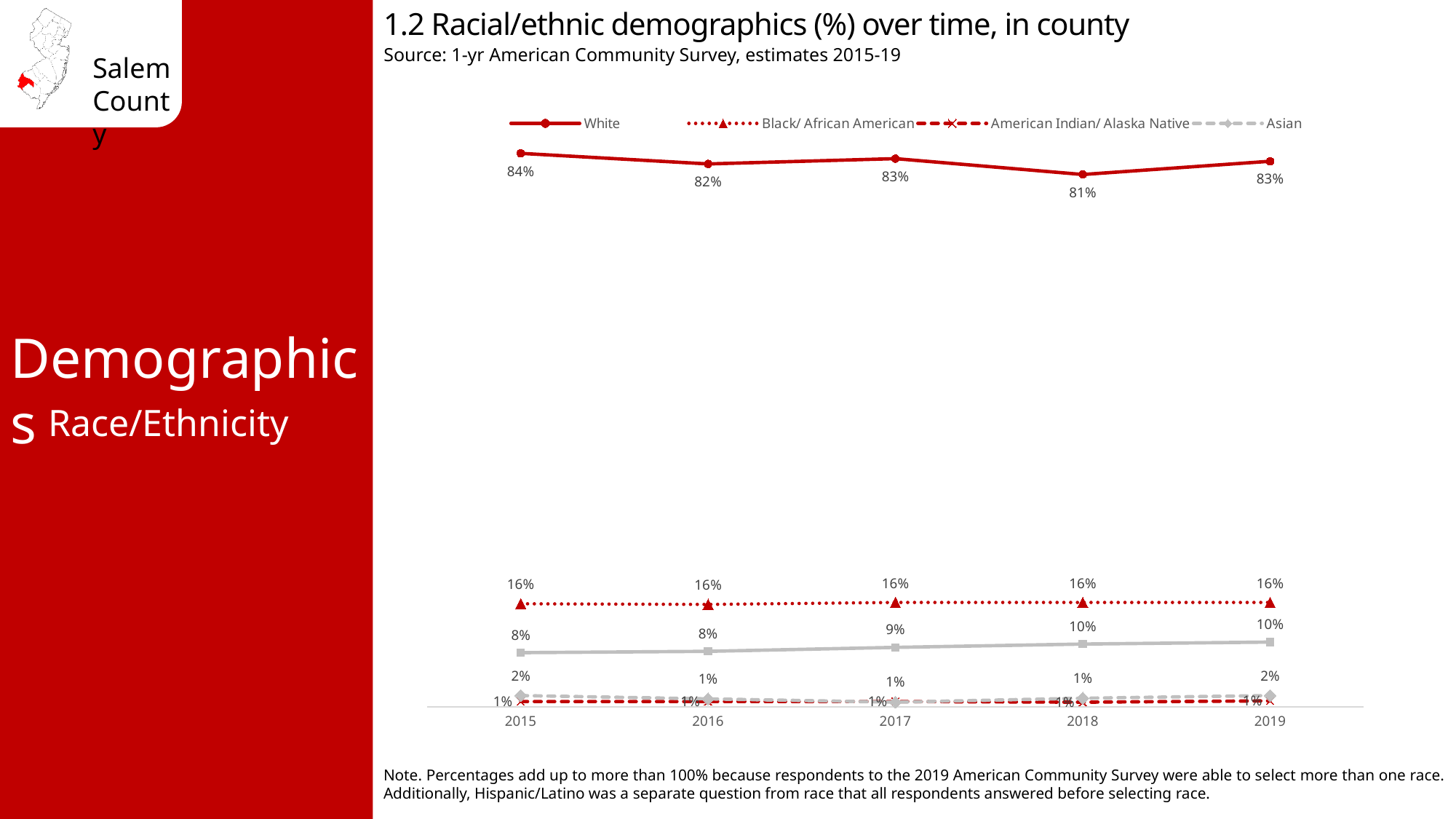
What is the difference between the White value in 2015 and in 2018? 3 percentage points What is the value for American Indian/ Alaska Native in 2016? 1% In which year is the White percentage lowest? 2018 What kind of chart is shown on the slide? Line chart What is the value for Black/ African American in 2017? 16% What is the value for White in 2015? 84% In which year is the White percentage highest? 2015 What is the value for Asian in 2019? 2% Which year has the larger White value, 2016 or 2017? 2017 What is the value for White in 2018? 81% Does the Black/ African American percentage rise, fall, or stay flat from 2015 to 2019? Stays flat How many years are shown on the x axis? 5